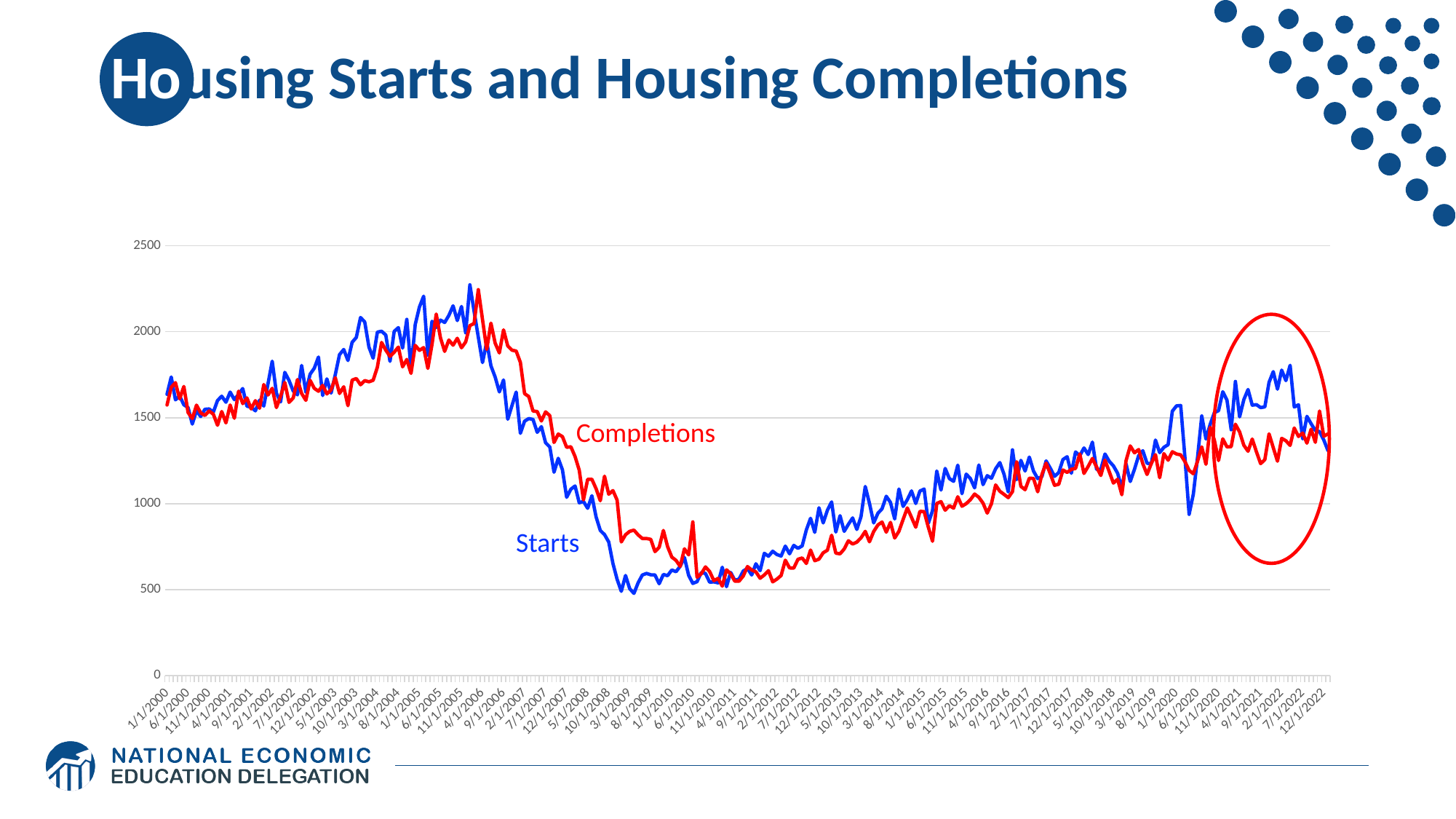
Do the Starts values rise or fall between 1/1/2006 and 3/1/2009? fall Is the value of Starts around 2/1/2022 greater or less than 1500? greater How many data series are plotted on the chart? 2 Around 2/1/2022, which series has the higher value, Starts or Completions? Starts Is the value of Starts at 1/1/2000 greater or less than 1500? greater What colour is the Starts line? blue What is the title of the slide? Housing Starts and Housing Completions Around 10/1/2008, which series has the higher value, Starts or Completions? Completions What kind of chart is shown on the slide? line chart Is the value of Starts around 10/1/2008 greater or less than 1000? less